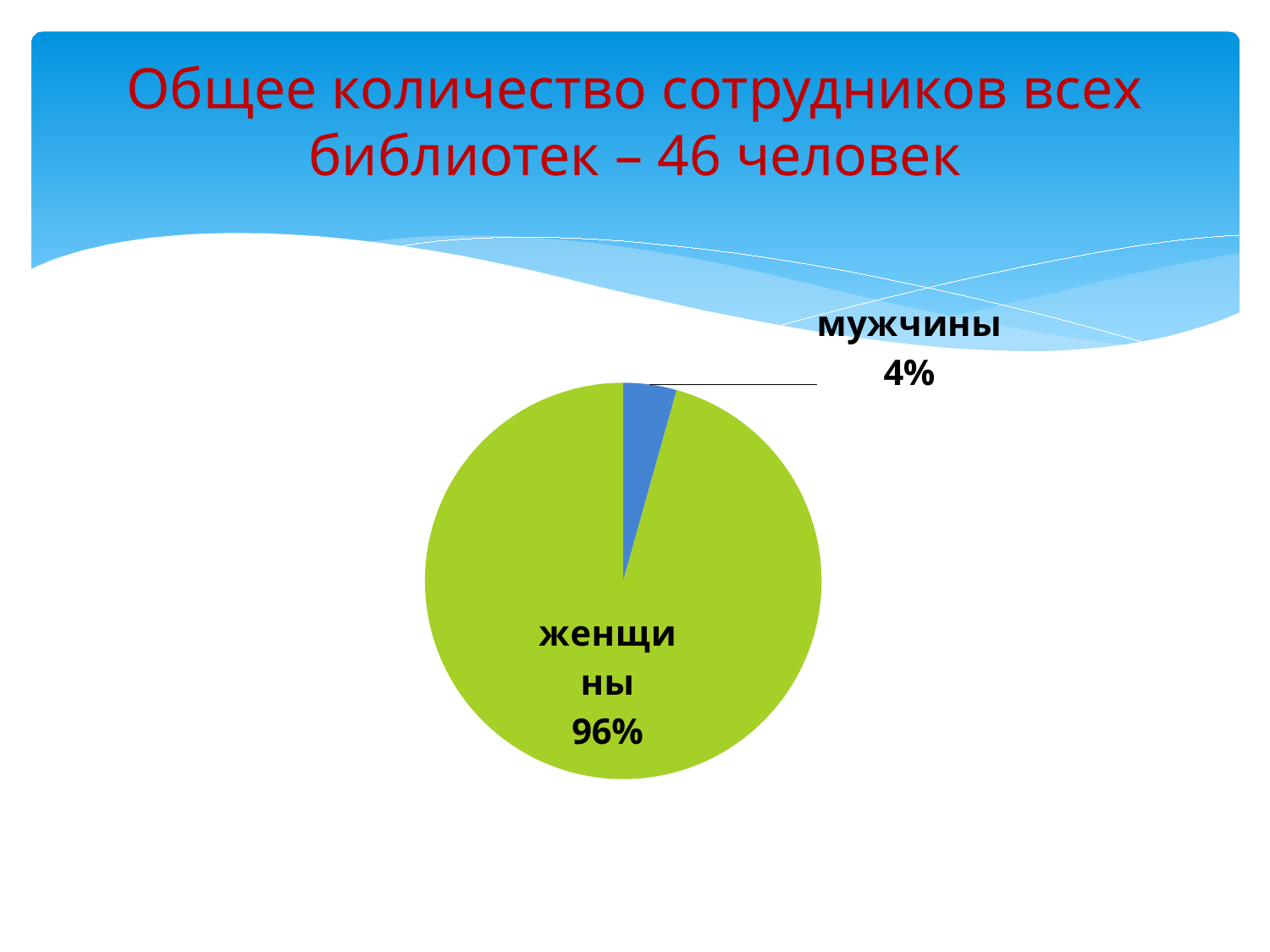
What is the total number of employees stated in the slide title? 46 человек Which slice of the pie is the smallest? мужчины How many slices does the pie chart have? 2 What colour is the мужчины slice? blue What share of the pie is labelled женщины? 96% What kind of chart is shown on the slide? pie chart What is the difference in percentage points between the женщины and мужчины slices? 92 What share of the pie is labelled мужчины? 4% Which slice is larger, женщины or мужчины? женщины Which slice of the pie is the largest? женщины What colour is the женщины slice? green